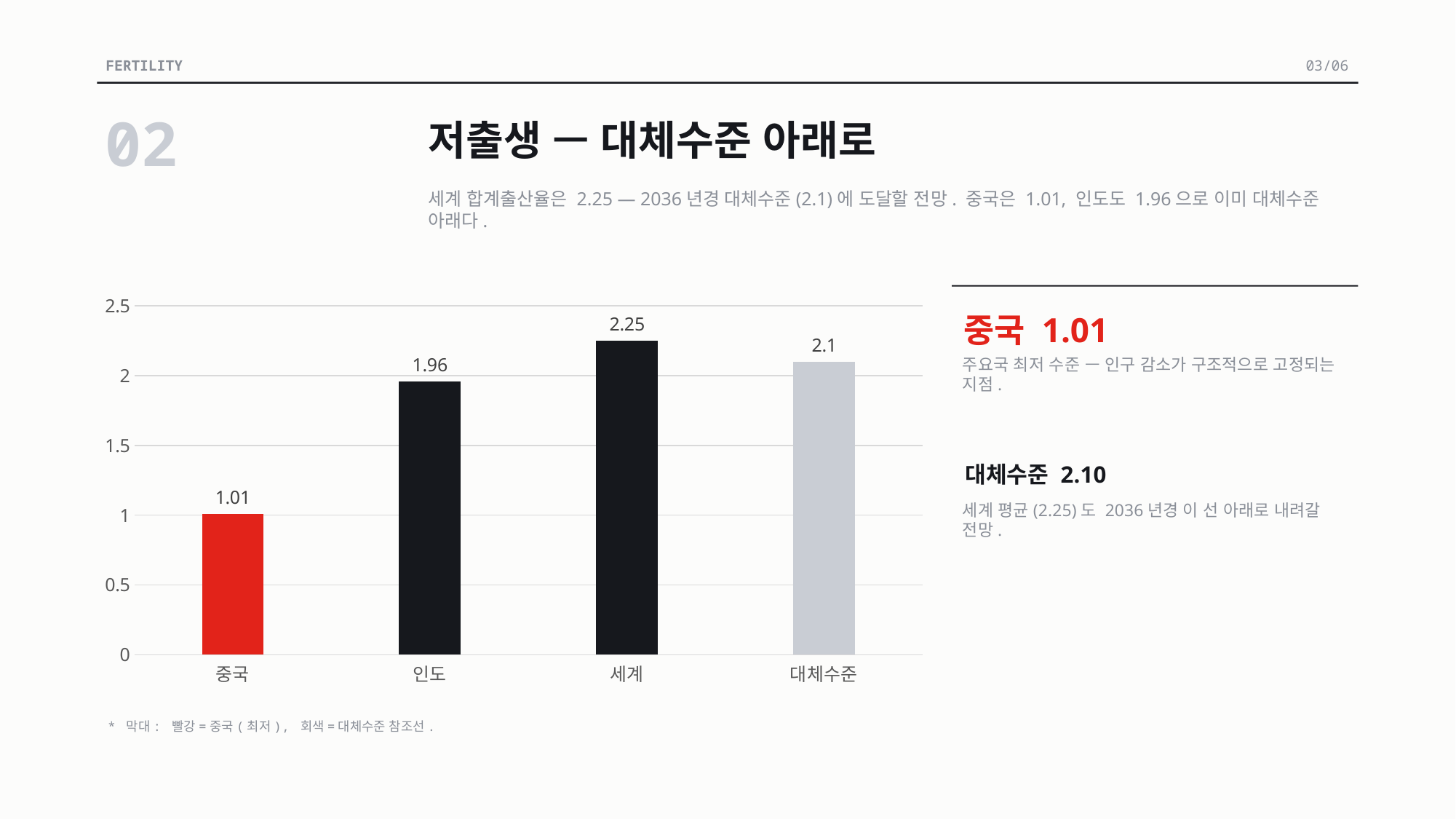
What is the value for 세계? 2.25 What is the difference between the values for 대체수준 and 인도? 0.14 Which category has the lowest value? 중국 How many categories are shown on the x axis? 4 What is the value for 인도? 1.96 What is the value for 대체수준? 2.1 Which category has the highest value? 세계 What is the value for 중국? 1.01 Which is larger, the value for 인도 or the value for 대체수준? 대체수준 What is the difference between the values for 세계 and 중국? 1.24 Is the value for 인도 greater or less than 1.5? greater What kind of chart is shown on the slide? bar chart